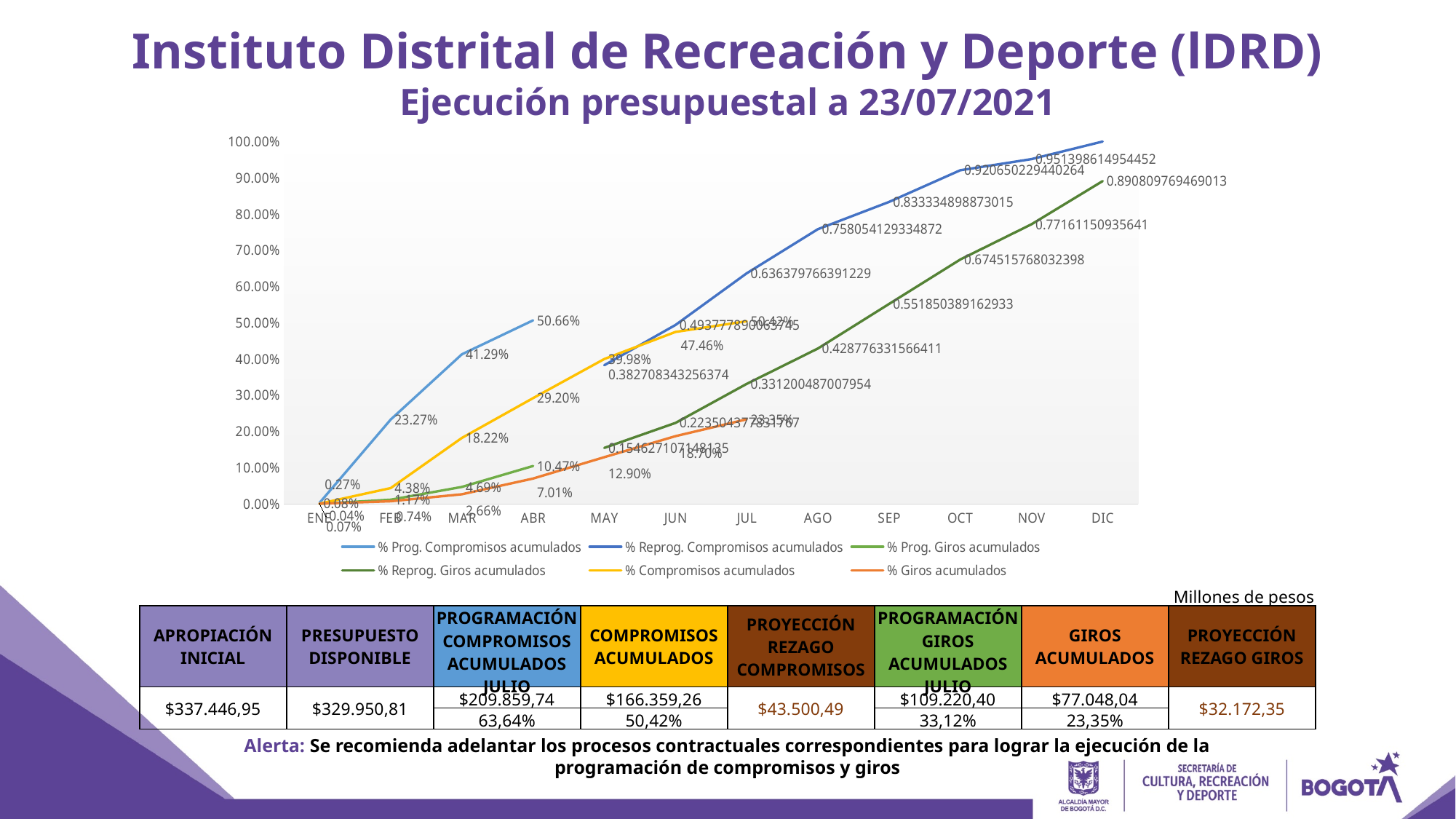
What is the difference between % Prog. Compromisos acumulados in ABR and in MAR? 9.37% Does the % Reprog. Giros acumulados line rise or fall from MAY to DIC? rises How many months are shown along the x axis of the chart? 12 What kind of chart is shown on the slide? line chart How many series does the chart legend list? 6 Is the value for % Reprog. Compromisos acumulados in DIC greater or less than 90.00%? greater What is the value of % Reprog. Compromisos acumulados in NOV? 0.951398614954452 What is the value of % Giros acumulados in MAY? 12.90% What is the value of % Reprog. Giros acumulados in DIC? 0.890809769469013 What is the value of % Compromisos acumulados in ABR? 29.20% What is the value of % Prog. Compromisos acumulados in ABR? 50.66% In ABR, which is larger: % Prog. Compromisos acumulados or % Compromisos acumulados? % Prog. Compromisos acumulados